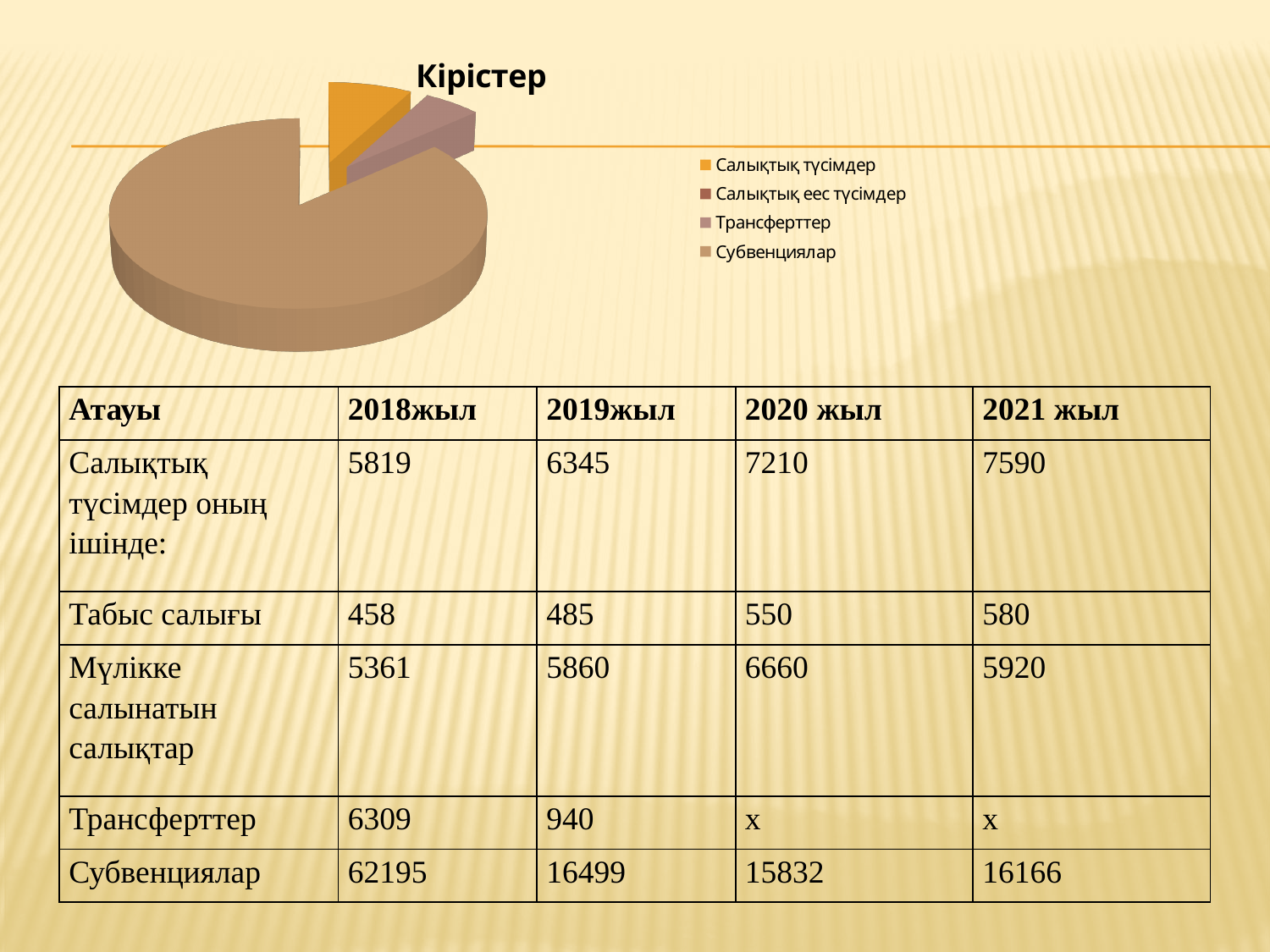
Which slice is larger, Субвенциялар or Трансферттер? Субвенциялар What kind of chart is shown on the slide? pie chart Which category has the largest slice of the pie? Субвенциялар Which slice is larger, Субвенциялар or Салықтық түсімдер? Субвенциялар Which legend entry is shown in orange? Салықтық түсімдер How many entries does the chart's legend list? 4 What is the title of the chart? Кірістер